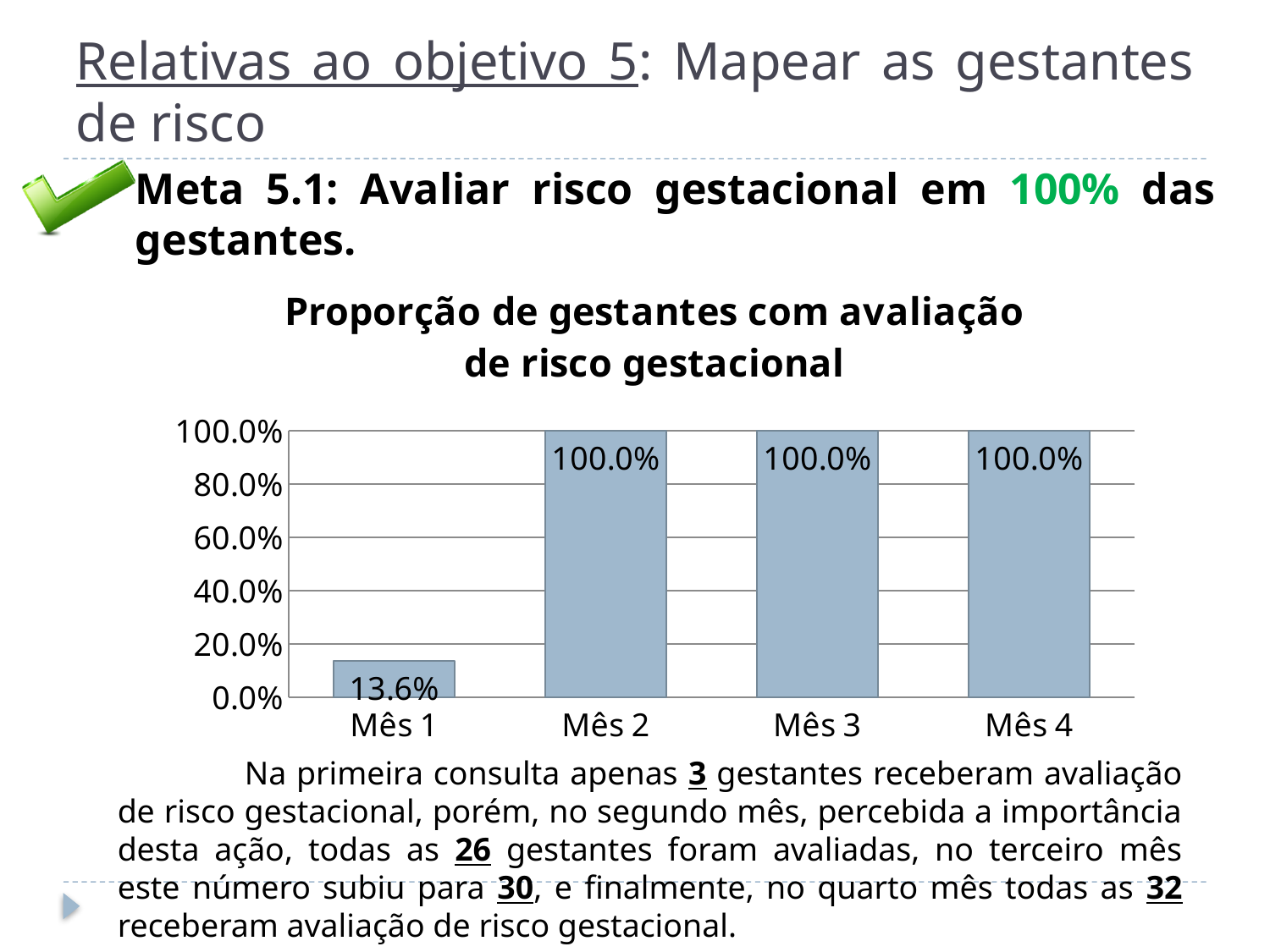
Do the values rise or fall from Mês 1 to Mês 2? rise What is the value for Mês 4? 100.0% What kind of chart is shown? bar chart What is the value for Mês 1? 13.6% How many months are shown on the x axis? 4 Which month has the lowest value? Mês 1 What is the value for Mês 2? 100.0% What is the difference between the values for Mês 2 and Mês 1? 86.4% What is the title of the chart? Proporção de gestantes com avaliação de risco gestacional Which is larger, the value for Mês 1 or the value for Mês 3? Mês 3 Is the value for Mês 1 greater or less than 20.0%? less How many months reach 100.0%? 3